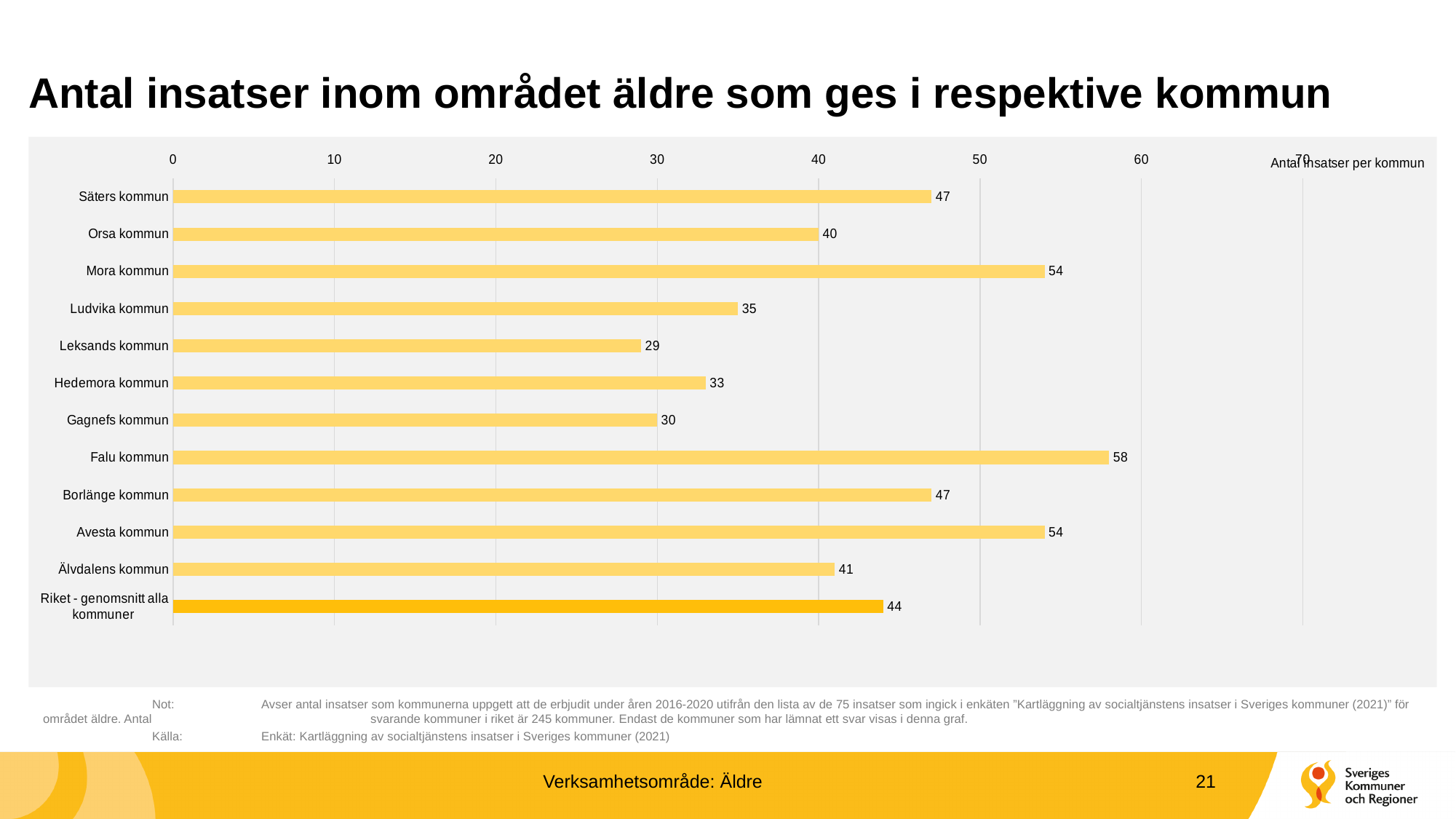
What is the value for Riket - genomsnitt alla kommuner? 44 Which category has the lowest value? Leksands kommun Is the value for Ludvika kommun greater or less than 40? less Which category has the highest value? Falu kommun What kind of chart is shown on the slide? bar chart What is the value for Mora kommun? 54 Which is larger, the value for Orsa kommun or the value for Älvdalens kommun? Älvdalens kommun What is the title of the chart? Antal insatser inom området äldre som ges i respektive kommun What is the legend entry shown on the chart? Antal insatser per kommun What is the difference between the values for Falu kommun and Gagnefs kommun? 28 What is the value for Leksands kommun? 29 How many categories are shown on the chart? 12